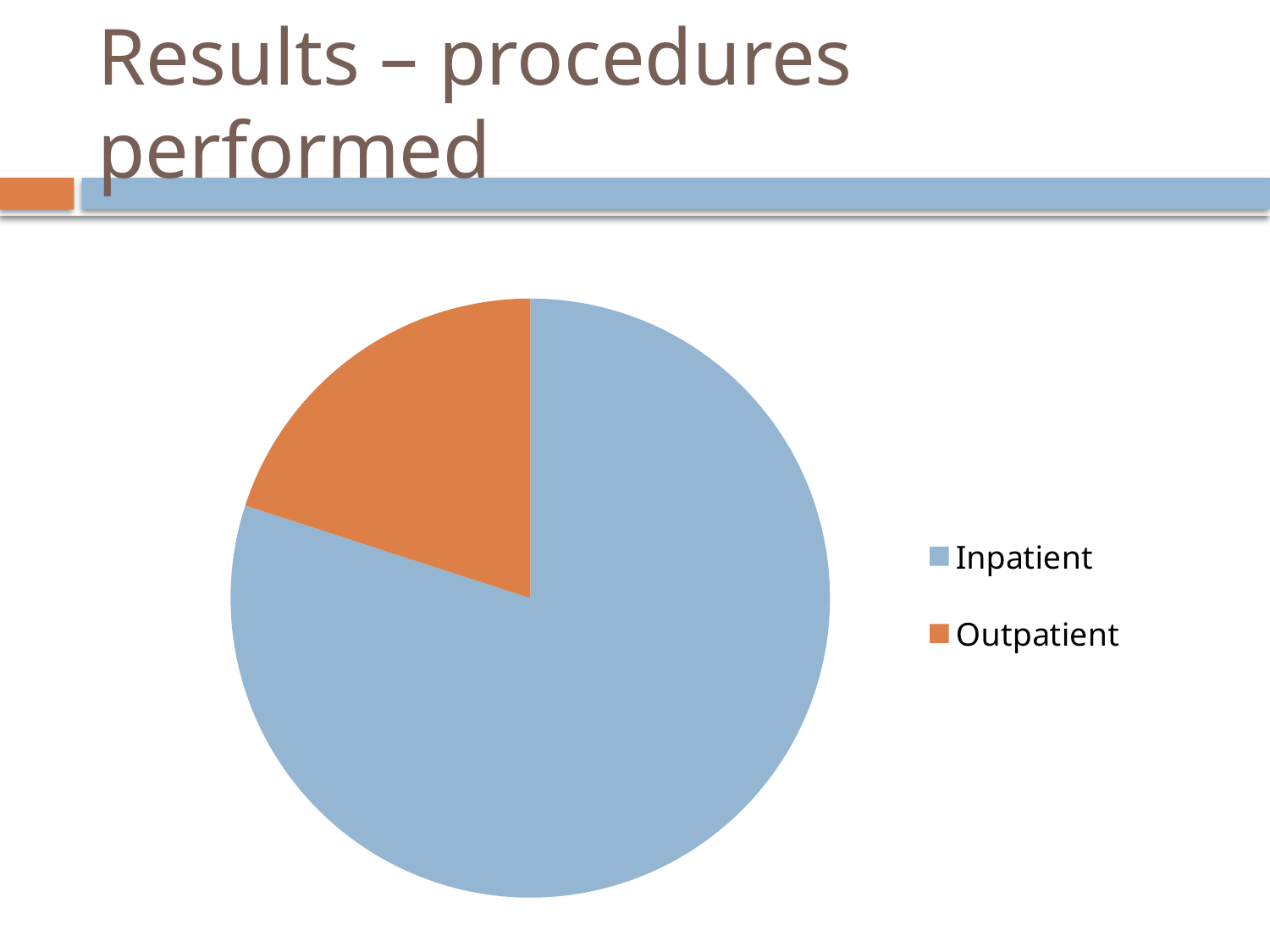
What colour is the Outpatient slice? orange Which category has the smallest slice of the pie? Outpatient What colour is the Inpatient slice? blue What kind of chart is shown on the slide? pie chart Which is larger, the Inpatient slice or the Outpatient slice? Inpatient How many slices does the pie chart have? 2 Which category has the largest slice of the pie? Inpatient How many entries does the legend list? 2